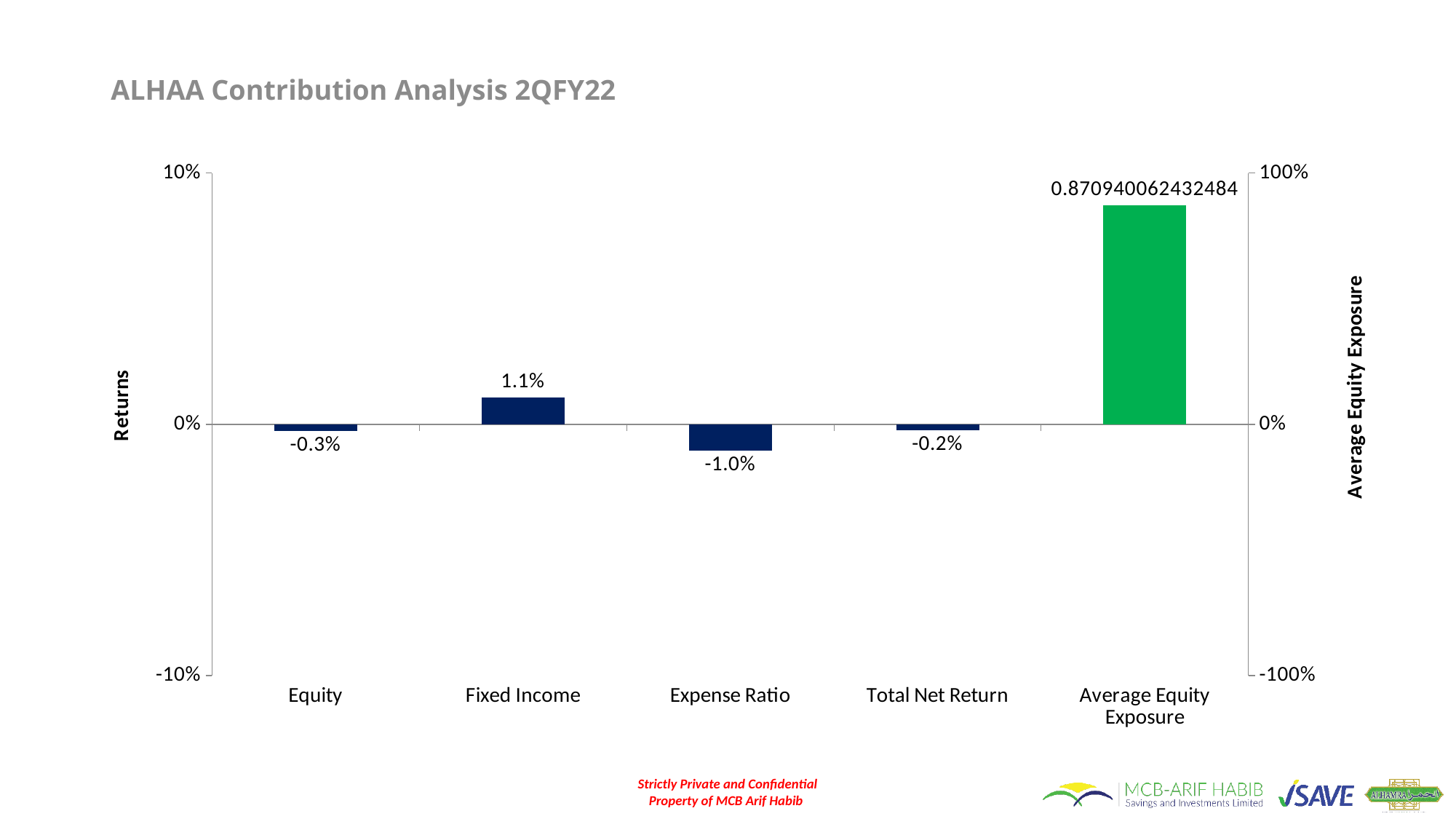
What is the title of the chart? ALHAA Contribution Analysis 2QFY22 What is the value for Equity? -0.3% How many categories are shown on the x axis? 5 What is the difference between the Fixed Income value and the Expense Ratio value? 2.1% What is the value for Total Net Return? -0.2% What is the value for Expense Ratio? -1.0% What kind of chart is shown on the slide? Bar chart Among Equity, Fixed Income, Expense Ratio and Total Net Return, which category has the highest return? Fixed Income What data label is shown on the Average Equity Exposure bar? 0.870940062432484 Which is larger, the value for Equity or the value for Total Net Return? Total Net Return Among Equity, Fixed Income, Expense Ratio and Total Net Return, which category has the lowest return? Expense Ratio What is the value for Fixed Income? 1.1%